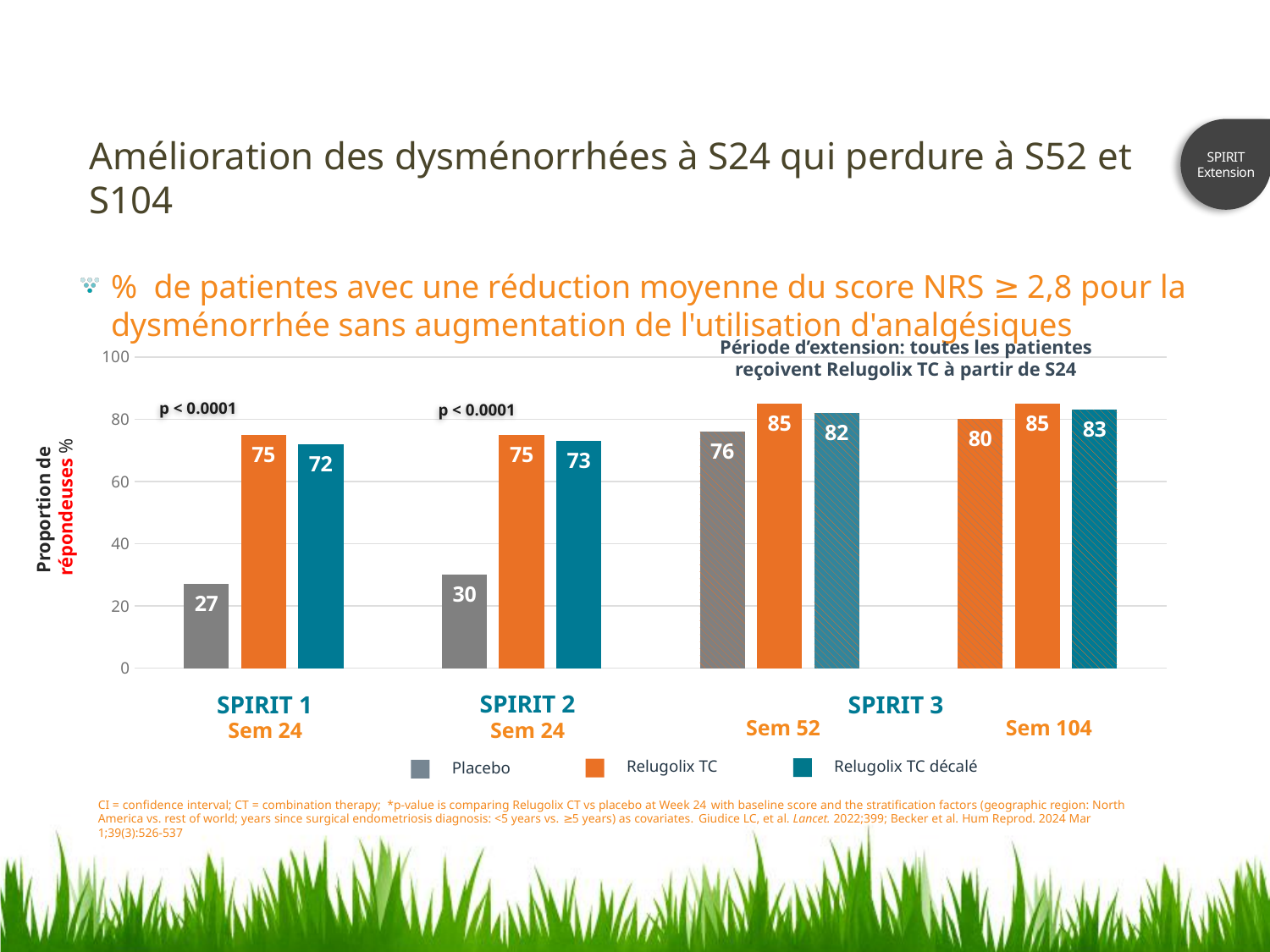
Which is larger in SPIRIT 3 at Sem 52: the Placebo value or the Relugolix TC décalé value? Relugolix TC décalé What is the value for Relugolix TC in SPIRIT 3 at Sem 52? 85 What kind of chart is shown on the slide? bar chart What is the value for Relugolix TC décalé in SPIRIT 2 at Sem 24? 73 Is the Placebo value in SPIRIT 2 at Sem 24 greater or less than 40? less What is the difference between the Relugolix TC and Placebo values in SPIRIT 1 at Sem 24? 48 How many series does the legend list? 3 What is the value for Placebo in SPIRIT 1 at Sem 24? 27 What is the value for Placebo in SPIRIT 3 at Sem 104? 80 Which group has the lowest Placebo value? SPIRIT 1 Sem 24 What is the label of the y axis? Proportion de répondeuses % What is the difference between the Relugolix TC and Placebo values in SPIRIT 2 at Sem 24? 45